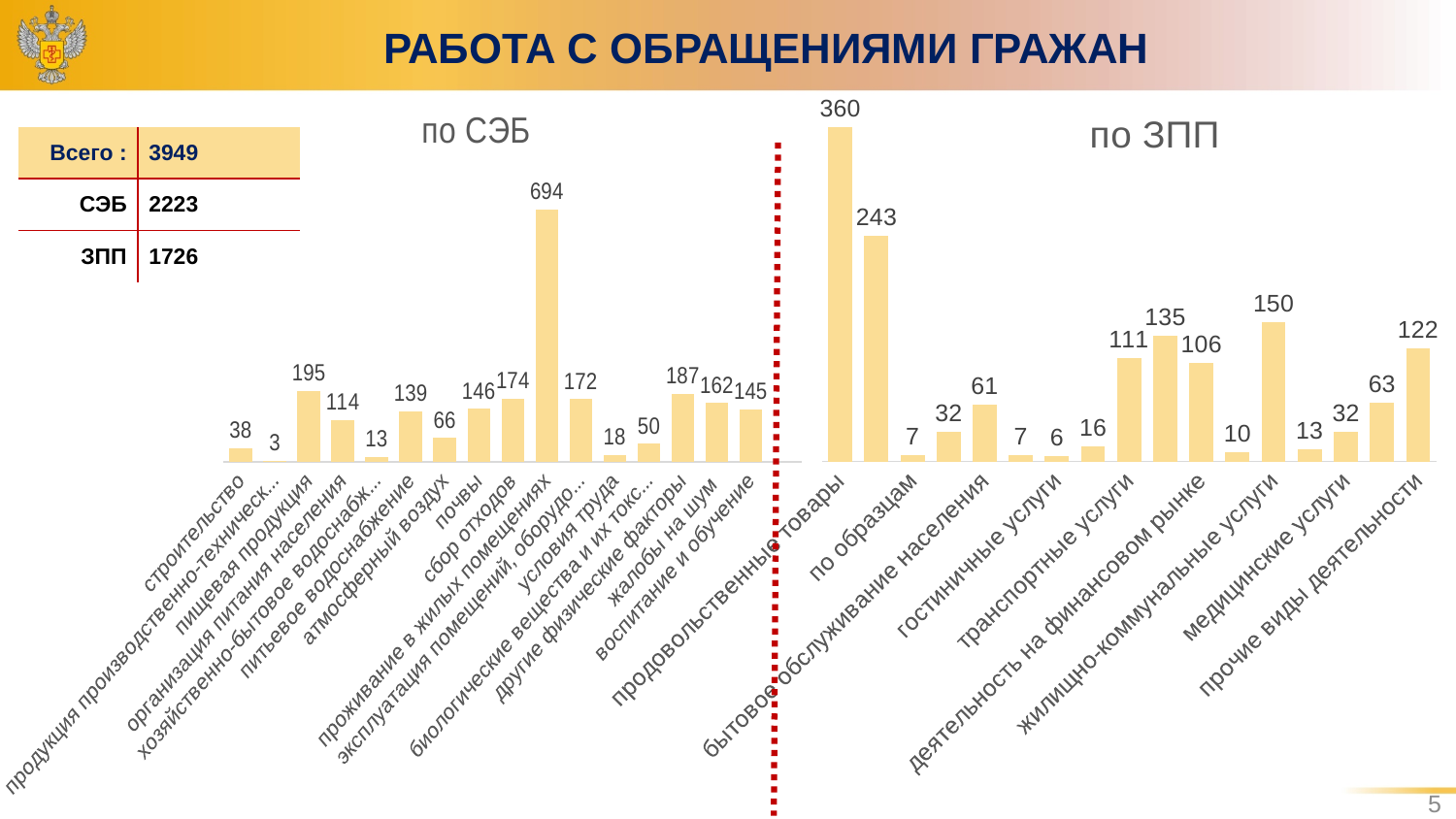
In the "по СЭБ" section, what is the value for "пищевая продукция"? 195 How many bars are in the "по СЭБ" section? 16 In the "по СЭБ" section, what is the difference between "сбор отходов" and "жалобы на шум"? 12 In the "по ЗПП" section, what is the difference between the two tallest bars (360 and 243)? 117 In the "по СЭБ" section, what is the lowest value shown? 3 In the "по ЗПП" section, what is the highest value shown? 360 In the "по СЭБ" section, which category has the highest value? проживание в жилых помещениях In the "по СЭБ" section, which is larger: "почвы" or "питьевое водоснабжение"? почвы In the "по СЭБ" section, what is the value for "атмосферный воздух"? 66 In the "по ЗПП" section, what is the lowest value shown? 6 What kind of chart is shown on the slide? bar chart In the "по СЭБ" section, what is the value for "проживание в жилых помещениях"? 694